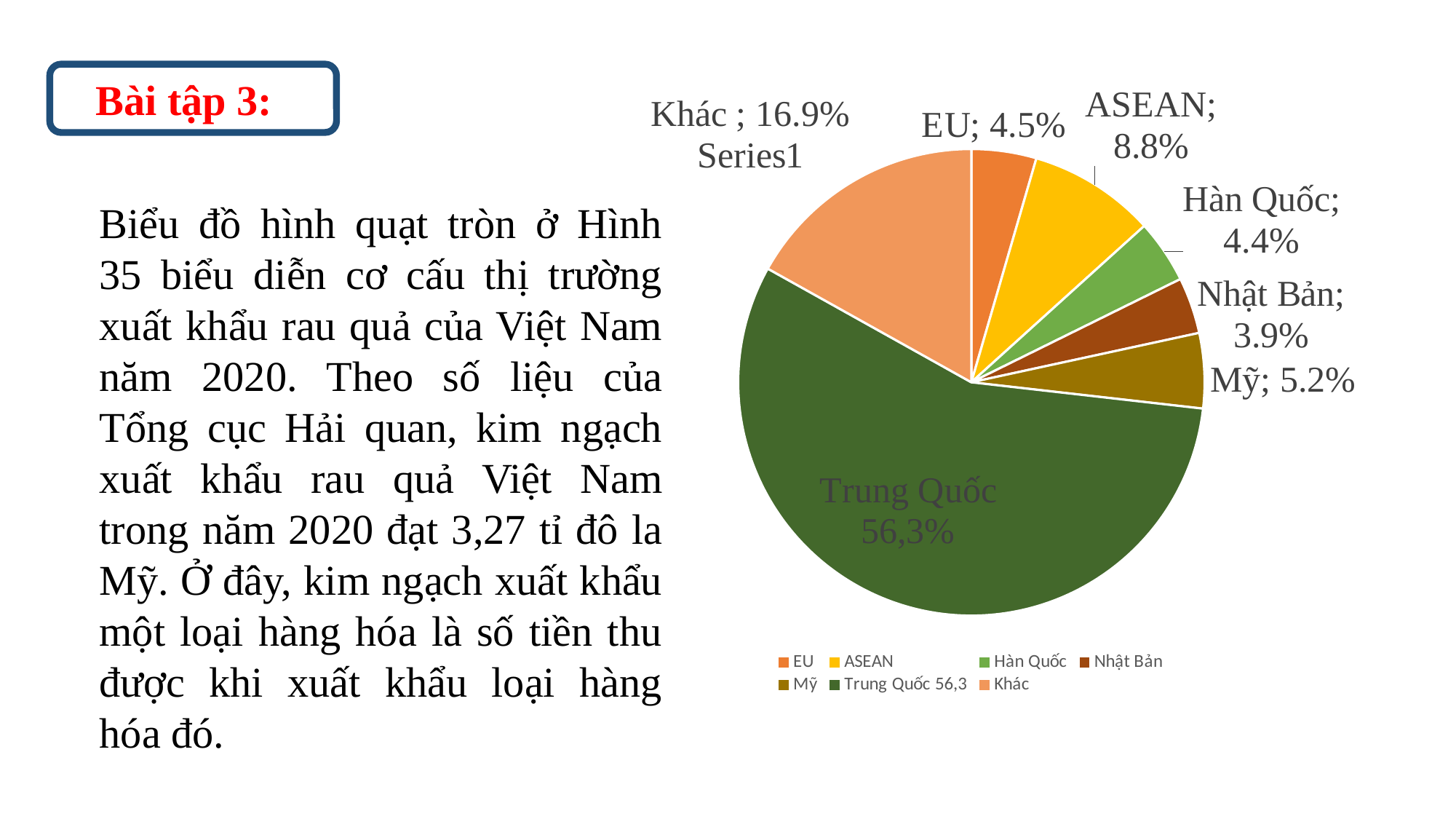
What is the value shown for ASEAN in the pie chart? 8.8% What type of chart is shown on the slide? pie chart What is the value shown for the Khác slice? 16.9% How many entries does the legend list? 7 Which is larger, the Mỹ slice or the Nhật Bản slice? Mỹ What is the difference between the Mỹ slice and the EU slice? 0.7% What is the difference between the Khác slice and the ASEAN slice? 8.1% What percentage of the pie chart does Trung Quốc account for? 56,3% Which slice of the pie chart is the largest? Trung Quốc Which slice of the pie chart is the smallest? Nhật Bản What is the value shown for Nhật Bản? 3.9% How many slices does the pie chart have? 7